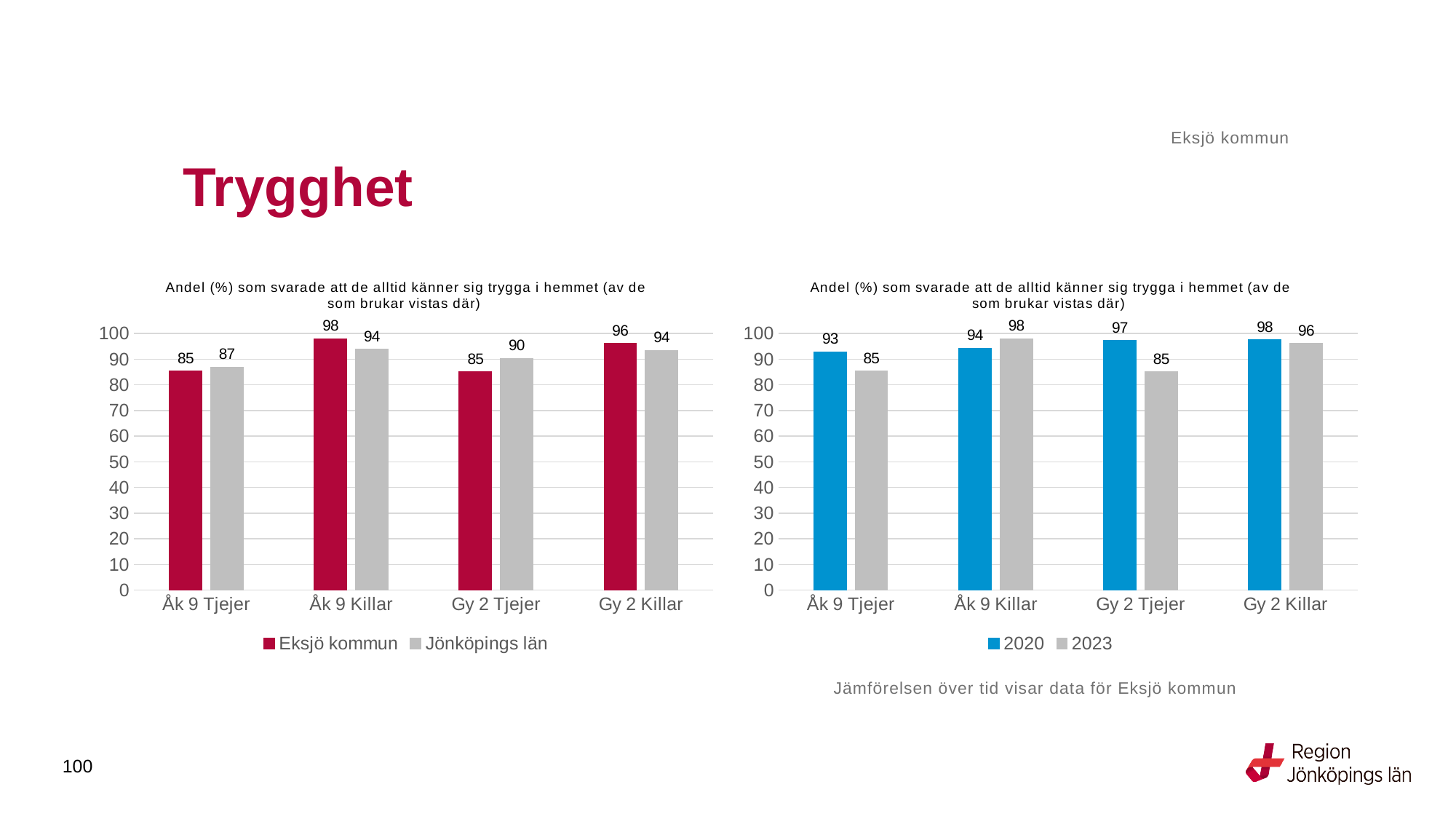
In the left chart, which category has the lowest value for Jönköpings län? Åk 9 Tjejer In the left chart, what is the value for Eksjö kommun for Åk 9 Killar? 98 In the right chart, which category has the highest value for 2020? Gy 2 Killar In the left chart, what is the difference between Eksjö kommun and Jönköpings län for Gy 2 Tjejer? 5 In the right chart, what is the value for 2020 for Åk 9 Tjejer? 93 In the right chart, what is the value for 2023 for Gy 2 Tjejer? 85 In the left chart, which is larger for Gy 2 Killar: Eksjö kommun or Jönköpings län? Eksjö kommun How many series does the legend of the right chart list? 2 In the left chart, what is the value for Jönköpings län for Gy 2 Tjejer? 90 What kind of chart is the left chart? Bar chart In the right chart, what is the difference between 2020 and 2023 for Gy 2 Tjejer? 12 In the right chart, which is larger for Åk 9 Killar: 2020 or 2023? 2023